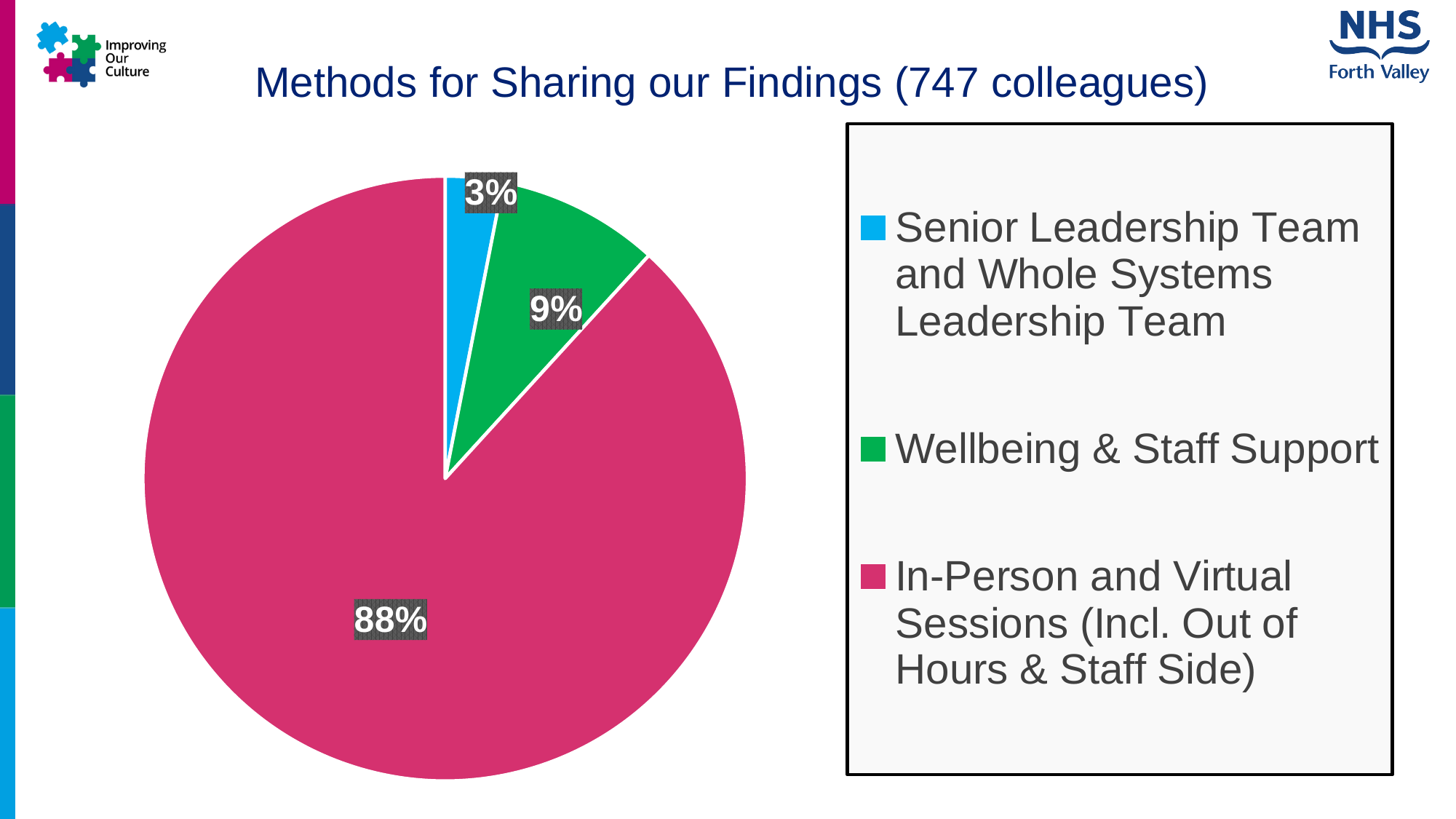
Which is larger: the Wellbeing & Staff Support slice or the Senior Leadership Team and Whole Systems Leadership Team slice? Wellbeing & Staff Support What is the difference in percentage points between the Wellbeing & Staff Support slice and the Senior Leadership Team and Whole Systems Leadership Team slice? 6 Which category has the smallest slice of the pie? Senior Leadership Team and Whole Systems Leadership Team Which category has the largest slice of the pie? In-Person and Virtual Sessions (Incl. Out of Hours & Staff Side) What share of the pie is Wellbeing & Staff Support? 9% What type of chart is shown on the slide? pie chart What is the title of the chart? Methods for Sharing our Findings (747 colleagues) What share of the pie is In-Person and Virtual Sessions (Incl. Out of Hours & Staff Side)? 88% What share of the pie is Senior Leadership Team and Whole Systems Leadership Team? 3% How many categories does the pie chart show? 3 What is the difference in percentage points between the In-Person and Virtual Sessions slice and the Wellbeing & Staff Support slice? 79 What colour is the Wellbeing & Staff Support slice? green